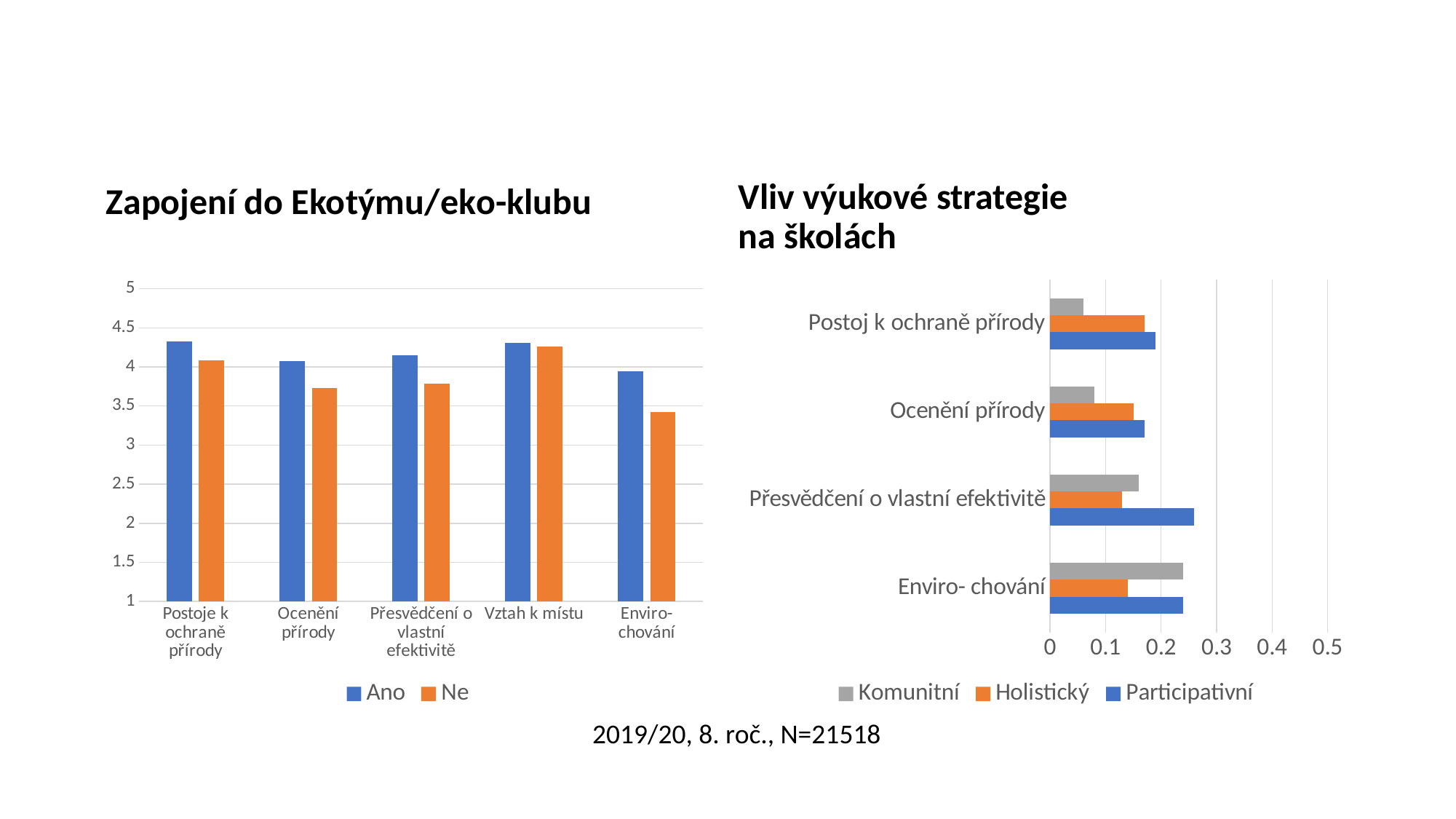
In the chart titled "Vliv výukové strategie na školách", is the Komunitní value for Postoj k ochraně přírody greater or less than 0.1? less How many categories are shown on the x axis of the chart titled "Zapojení do Ekotýmu/eko-klubu"? 5 In the chart titled "Zapojení do Ekotýmu/eko-klubu", which category has the lowest value for the Ne series? Enviro-chování In the chart titled "Vliv výukové strategie na školách", which is larger for Postoj k ochraně přírody, Komunitní or Holistický? Holistický How many categories are shown in the chart titled "Vliv výukové strategie na školách"? 4 What kind of chart is the chart titled "Zapojení do Ekotýmu/eko-klubu"? bar chart In the chart titled "Zapojení do Ekotýmu/eko-klubu", is the Ano value for Postoje k ochraně přírody greater or less than 4? greater In the chart titled "Vliv výukové strategie na školách", which category has the highest Participativní value? Přesvědčení o vlastní efektivitě In the chart titled "Zapojení do Ekotýmu/eko-klubu", is the Ne value for Enviro-chování greater or less than 3.5? less In the chart titled "Zapojení do Ekotýmu/eko-klubu", which is larger for Ocenění přírody, Ano or Ne? Ano How many series does the legend of the chart titled "Zapojení do Ekotýmu/eko-klubu" list? 2 How many series does the legend of the chart titled "Vliv výukové strategie na školách" list? 3